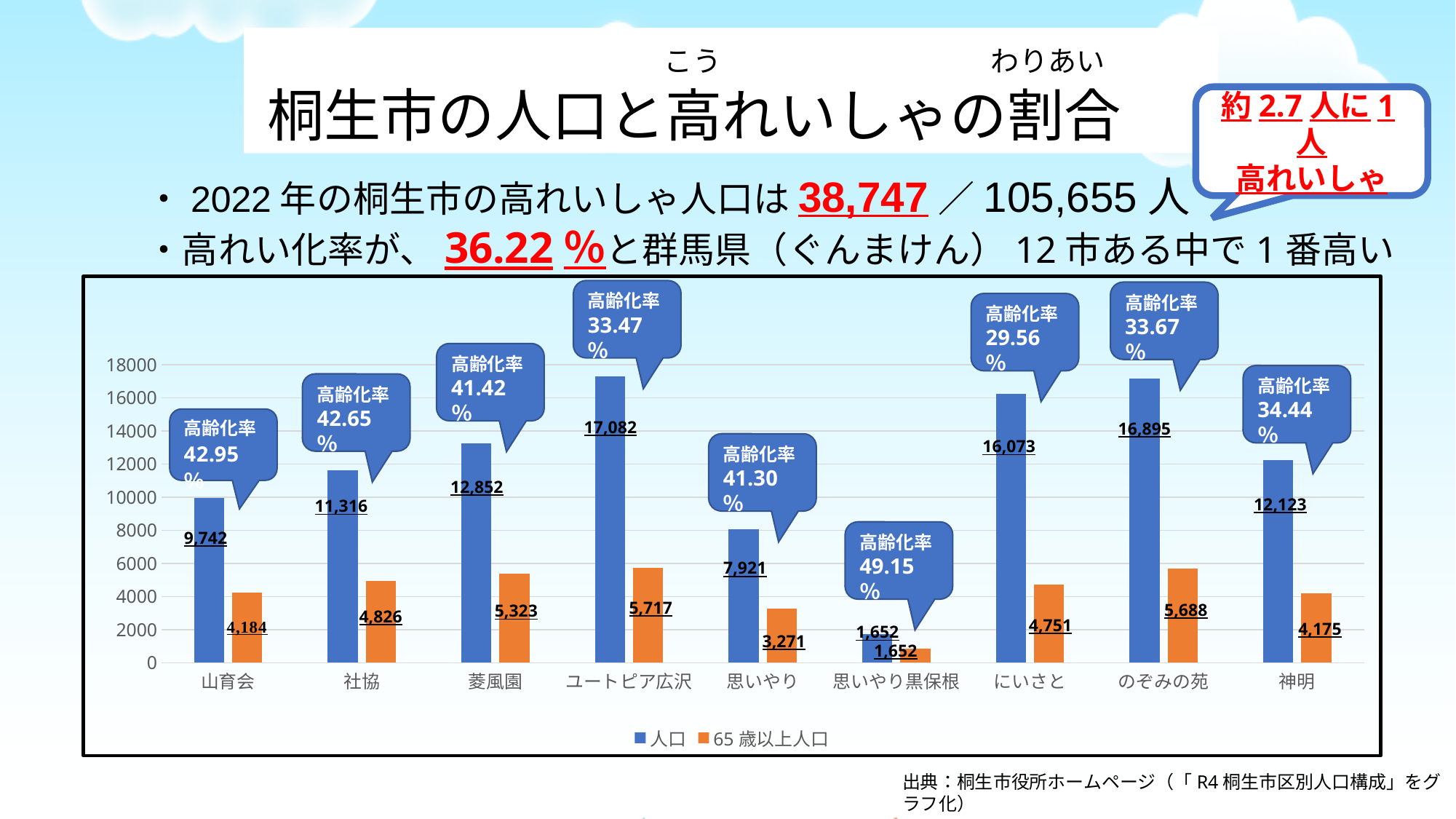
Which category has the lowest 人口 value? 思いやり黒保根 What is the 人口 value for ユートピア広沢? 17,082 What is the difference between the 人口 and 65歳以上人口 values for ユートピア広沢? 11,365 Which category has the highest 人口 value? ユートピア広沢 What is the difference between the 人口 values for 社協 and 山育会? 1,574 What kind of chart is shown on the slide? bar chart What is the 65歳以上人口 value for のぞみの苑? 5,688 How many categories are shown on the x axis of the chart? 9 What is the 人口 value for 神明? 12,123 Which is larger, the 人口 value for にいさと or for のぞみの苑? のぞみの苑 Is the 人口 value for にいさと greater or less than 14000? greater How many series does the chart legend list? 2